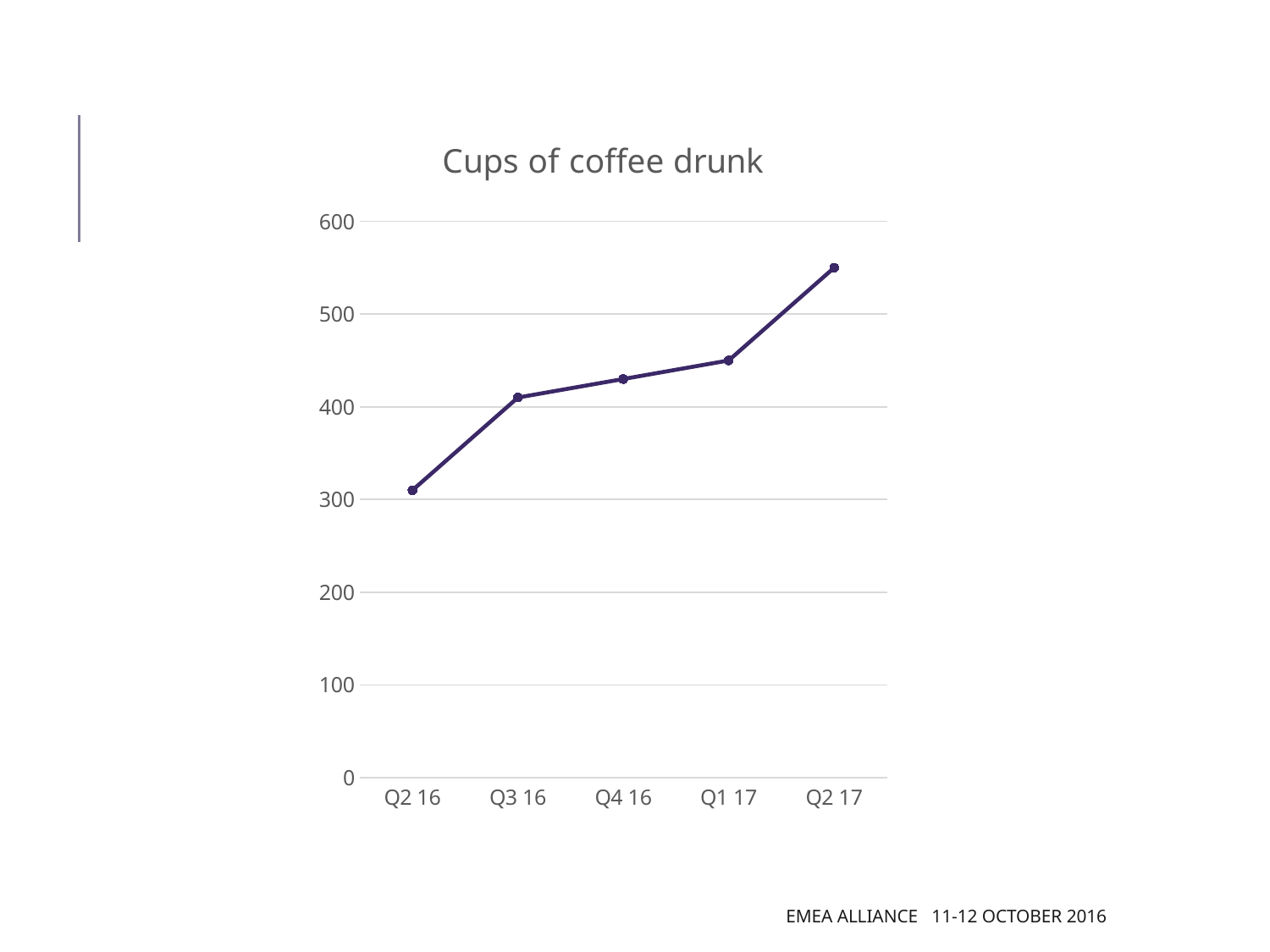
What is the title of the chart? Cups of coffee drunk Is the value for Q2 16 greater or less than 400? less Which quarter has the highest number of cups of coffee drunk? Q2 17 Is the value for Q1 17 greater or less than 500? less Which is larger, the value for Q2 16 or the value for Q2 17? Q2 17 Is the value for Q4 16 greater or less than 400? greater Do the values rise or fall from Q2 16 to Q2 17? rise Which quarter has the lowest number of cups of coffee drunk? Q2 16 How many data points are plotted on the line? 5 Which is larger, the value for Q3 16 or the value for Q1 17? Q1 17 What kind of chart is shown on the slide? line chart